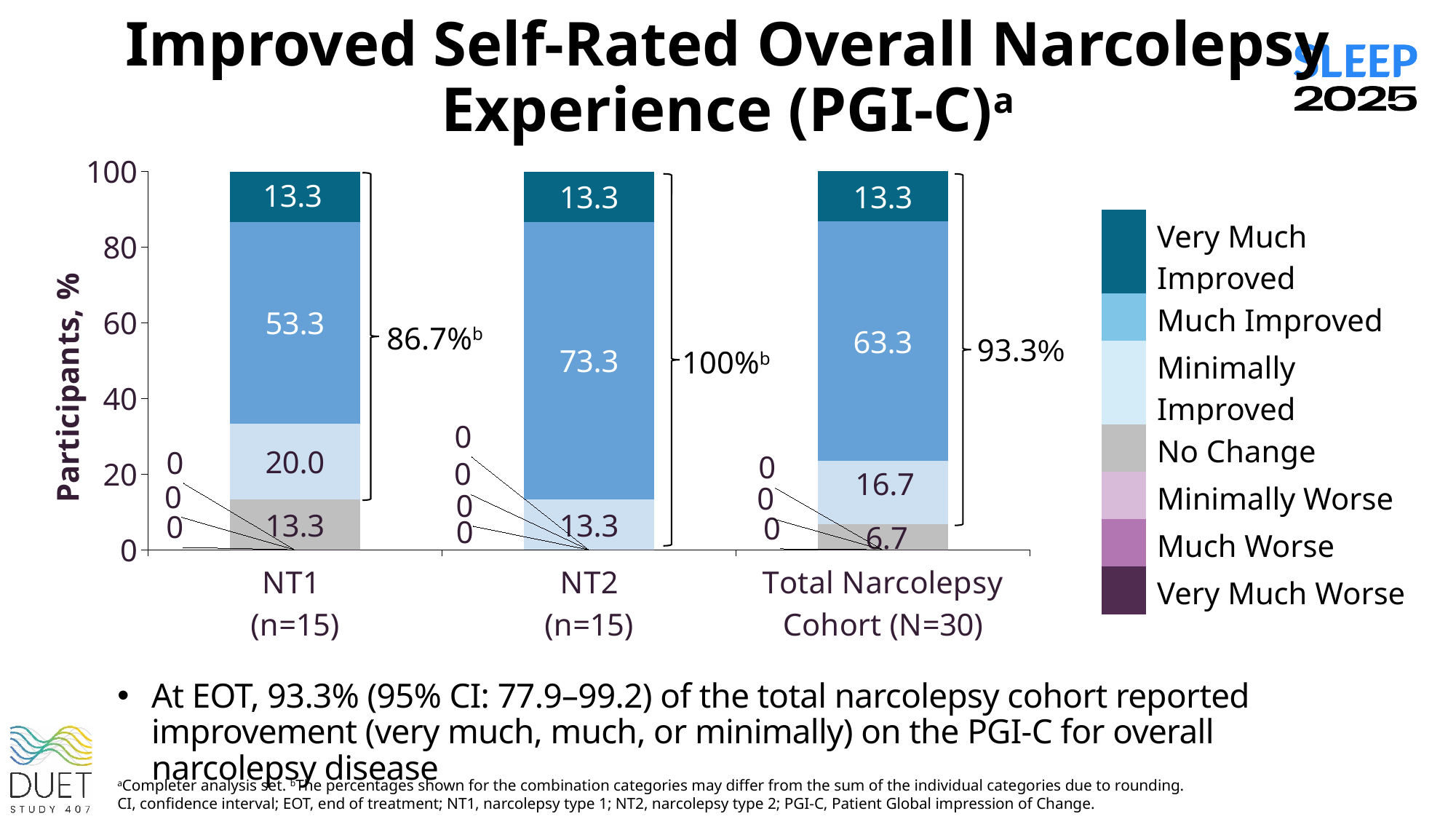
How many groups (bars) are plotted along the x axis? 3 What kind of chart is shown on the slide? Stacked bar chart How many entries does the legend list? 7 What percentage of the Total Narcolepsy Cohort reported No Change? 6.7 What is the Very Much Improved value for the Total Narcolepsy Cohort? 13.3 Which has the larger Minimally Improved value, NT1 or the Total Narcolepsy Cohort? NT1 Which group has the highest Much Improved percentage? NT2 What is the label on the y axis? Participants, % What is the Minimally Improved value for NT1? 20.0 What combined improvement percentage is shown by the bracket next to the NT1 bar? 86.7% What percentage of NT2 participants were Much Improved? 73.3 What is the difference between the Much Improved values for NT2 and NT1? 20.0